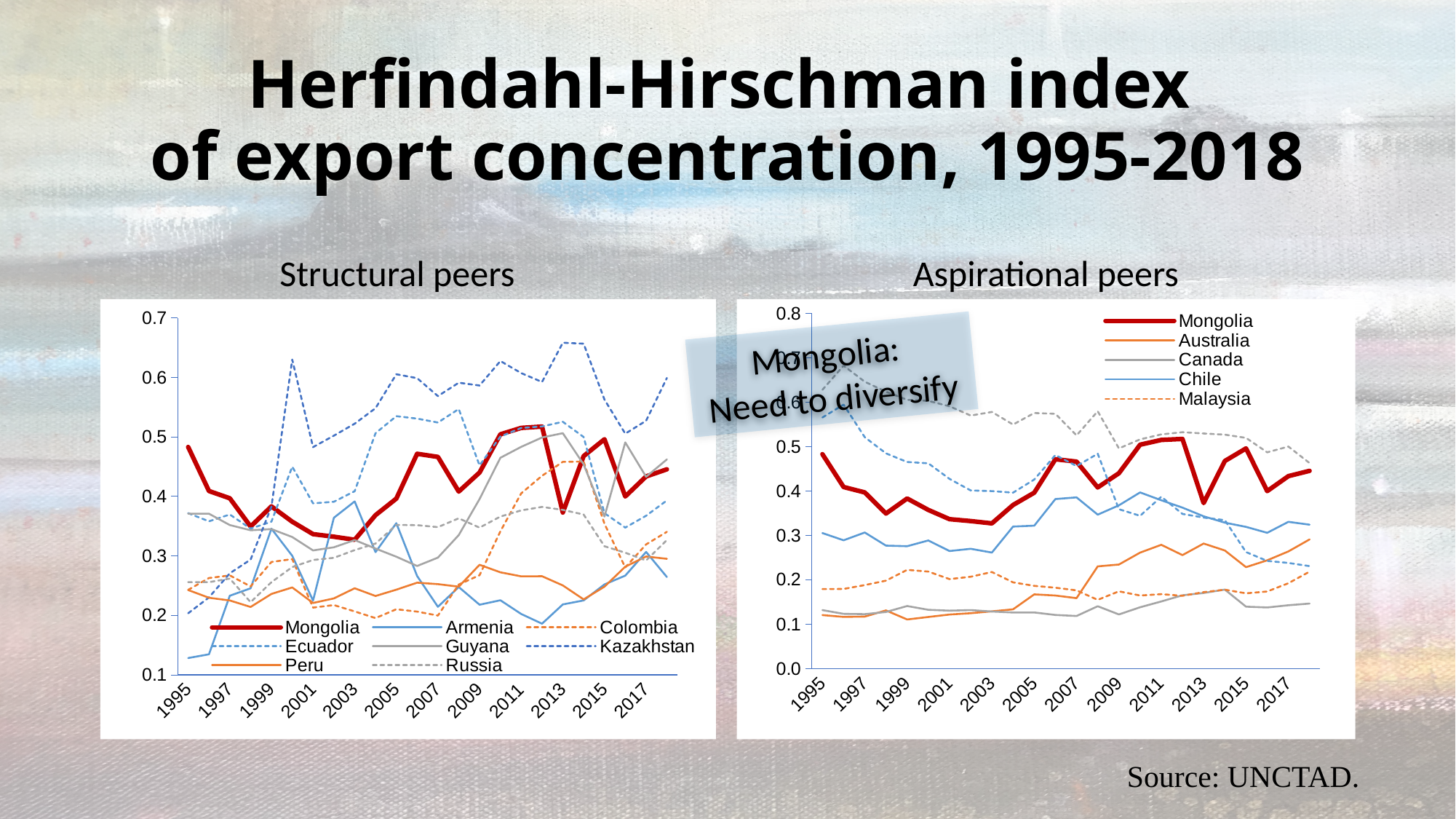
In the Aspirational peers chart, is the value for Canada in 1997 greater or less than 0.5? less How many series does the legend of the Aspirational peers chart list? 5 In the Aspirational peers chart, is the value for Australia in 1995 greater or less than 0.2? less In the Aspirational peers chart, is the value for Mongolia in 1995 greater or less than 0.4? greater What kind of chart is the Structural peers chart? line chart Which series is drawn with the thick red line in both charts? Mongolia In the Aspirational peers chart, does the value for Australia rise or fall overall from 1995 to 2018? rise In the Structural peers chart, which is larger in 2013, Kazakhstan or Armenia? Kazakhstan How many series does the legend of the Structural peers chart list? 8 In the Aspirational peers chart, which is larger in 1995, Mongolia or Australia? Mongolia